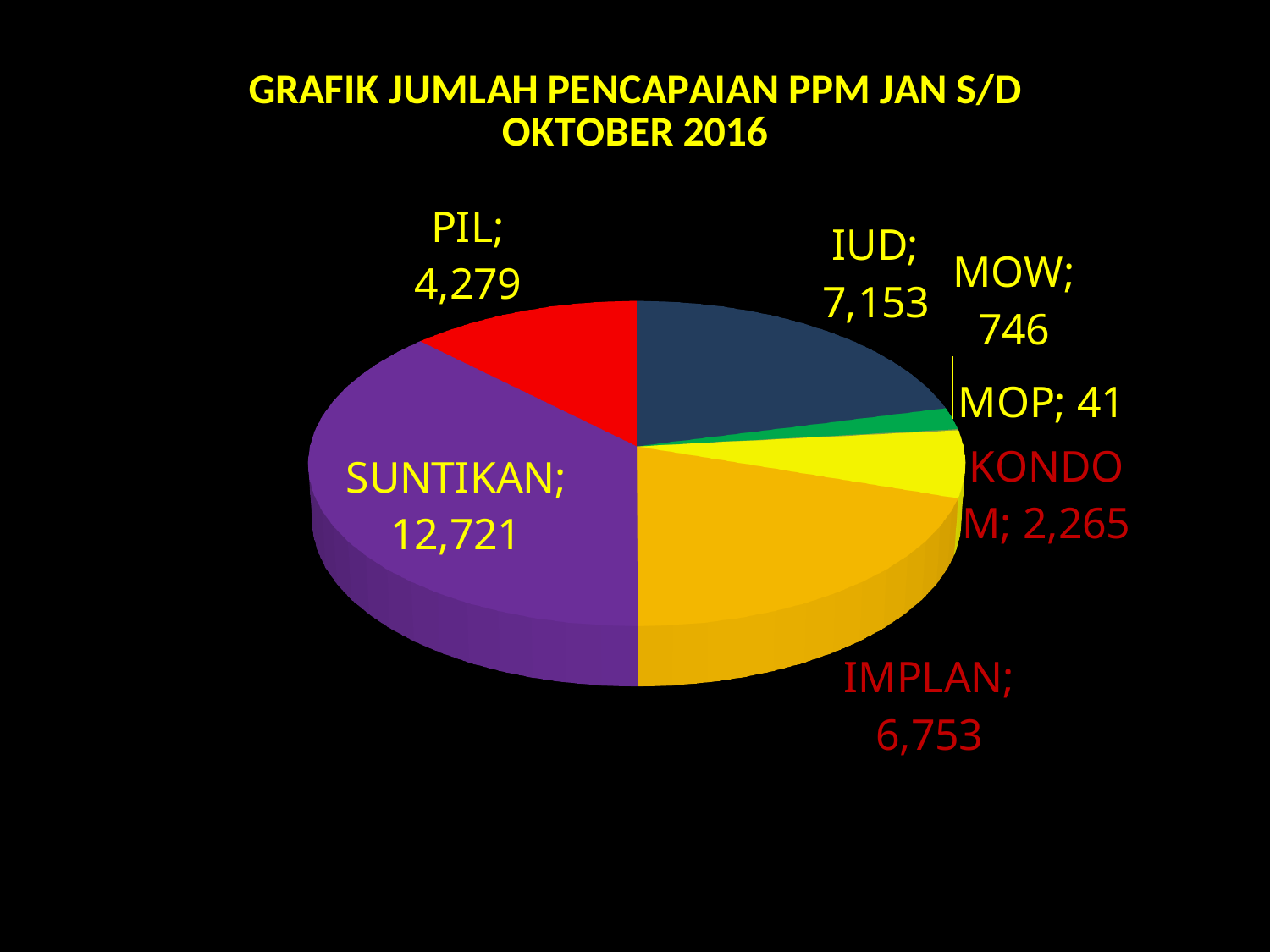
What is the value for IUD? 7,153 How many categories are shown in the pie chart? 7 Which category has the smallest slice of the pie? MOP Which category has the largest slice of the pie? SUNTIKAN Which is larger, the value for PIL or the value for KONDOM? PIL What is the value for SUNTIKAN? 12,721 What kind of chart is shown on the slide? Pie chart What is the difference between the values for IUD and IMPLAN? 400 What is the title of the chart? GRAFIK JUMLAH PENCAPAIAN PPM JAN S/D OKTOBER 2016 What is the value for MOP? 41 What is the value for KONDOM? 2,265 What is the difference between the values for SUNTIKAN and IUD? 5,568